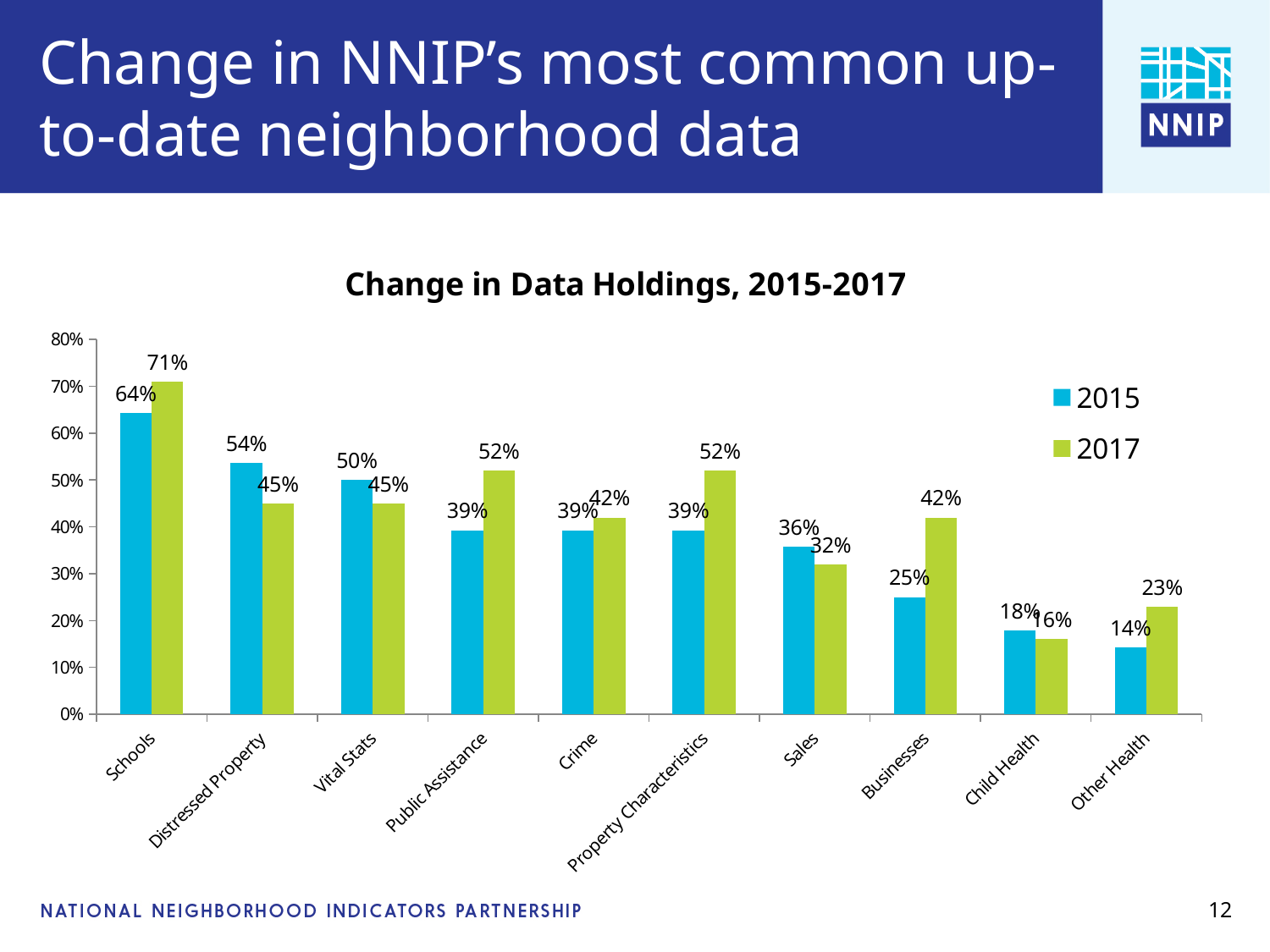
How many categories are shown on the x axis? 10 How many series does the legend list? 2 What is the difference between the 2017 and 2015 values for Businesses? 17% What is the 2015 value for Businesses? 25% Which is larger for Sales, the 2015 value or the 2017 value? 2015 What is the 2017 value for Schools? 71% What kind of chart is shown? bar chart Which category has the highest 2015 value? Schools What is the difference between the 2015 and 2017 values for Distressed Property? 9% Which category has the lowest 2017 value? Child Health What is the 2017 value for Other Health? 23% What is the title of the chart? Change in Data Holdings, 2015-2017